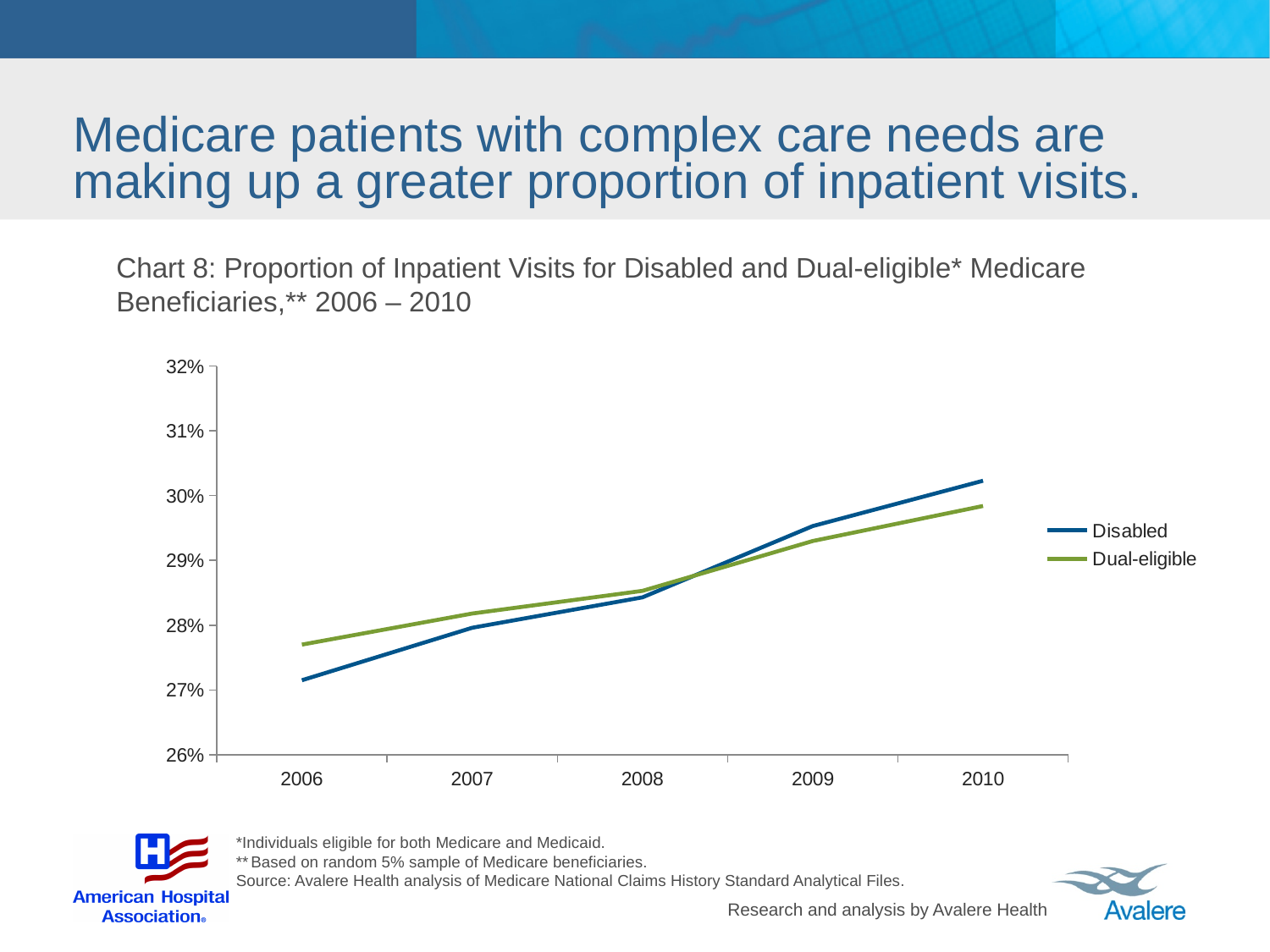
How many series does the legend list? 2 In which year is the Disabled series at its highest? 2010 Is the value for Disabled in 2009 greater or less than 29%? greater In 2010, which series has the higher value, Disabled or Dual-eligible? Disabled How many years are plotted along the x axis? 5 Is the value for Disabled in 2006 greater or less than 28%? less Does the Disabled line rise or fall from 2006 to 2010? rise In 2006, which series has the higher value, Disabled or Dual-eligible? Dual-eligible Is the value for Disabled in 2010 greater or less than 30%? greater What kind of chart is shown on the slide? line chart Does the Dual-eligible line rise or fall from 2006 to 2010? rise